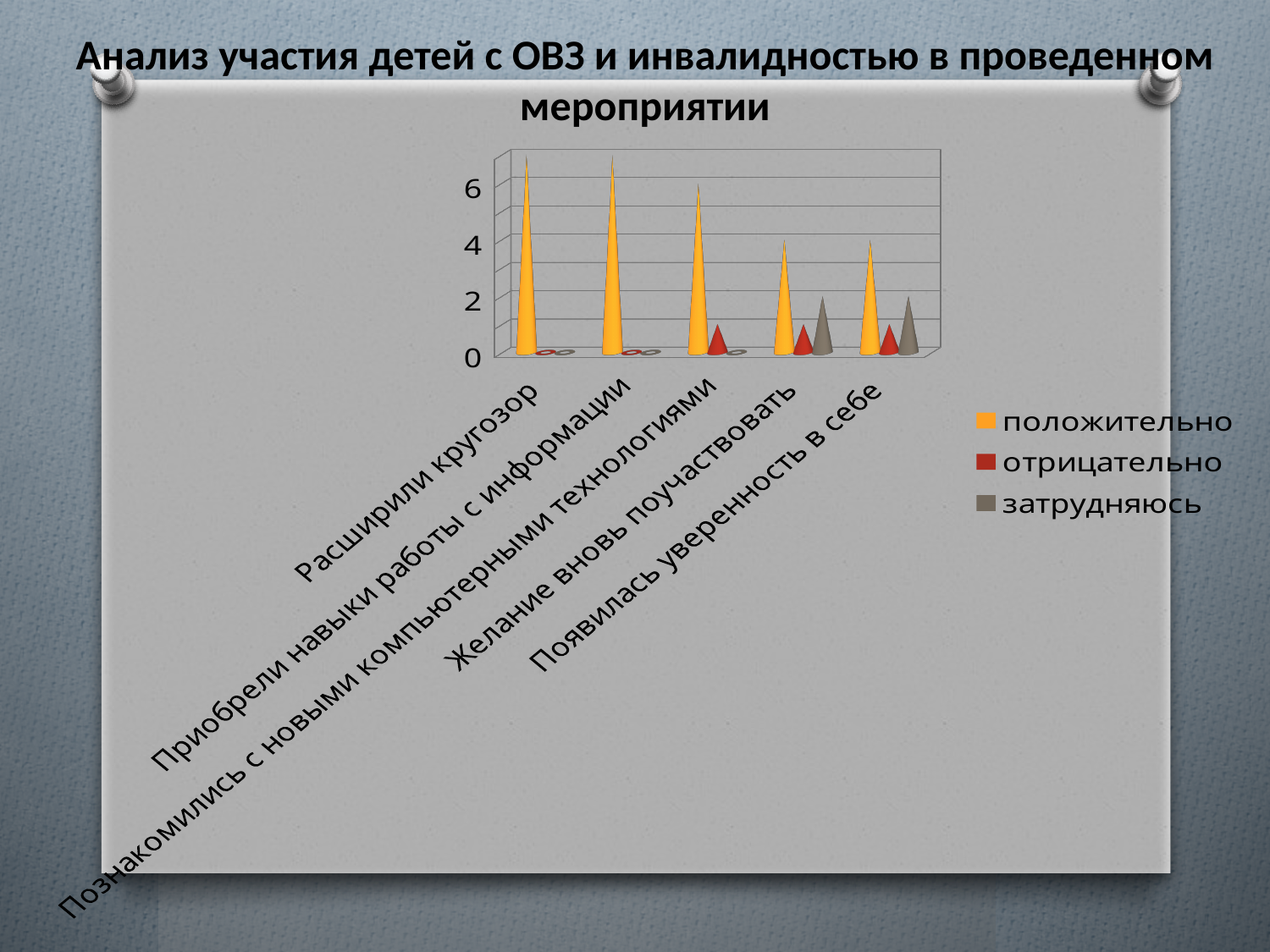
Is the value for "отрицательно" in the category "Познакомились с новыми компьютерными технологиями" greater or less than 2? less What is the title of the chart on the slide? Анализ участия детей с ОВЗ и инвалидностью в проведенном мероприятии Which series is shown in yellow in the chart legend? положительно How many series does the chart legend list? 3 Is the value for "положительно" in the category "Расширили кругозор" greater or less than 6? greater Is the value for "положительно" in the category "Желание вновь поучаствовать" greater or less than 2? greater In the category "Появилась уверенность в себе", which series has the larger value: "положительно" or "затрудняюсь"? положительно How many categories are shown on the x axis of the chart? 5 Do the values of the "положительно" series generally rise or fall from left to right along the x axis? fall What kind of chart is shown on the slide? bar chart Which is larger: the "положительно" value for "Расширили кругозор" or for "Желание вновь поучаствовать"? Расширили кругозор